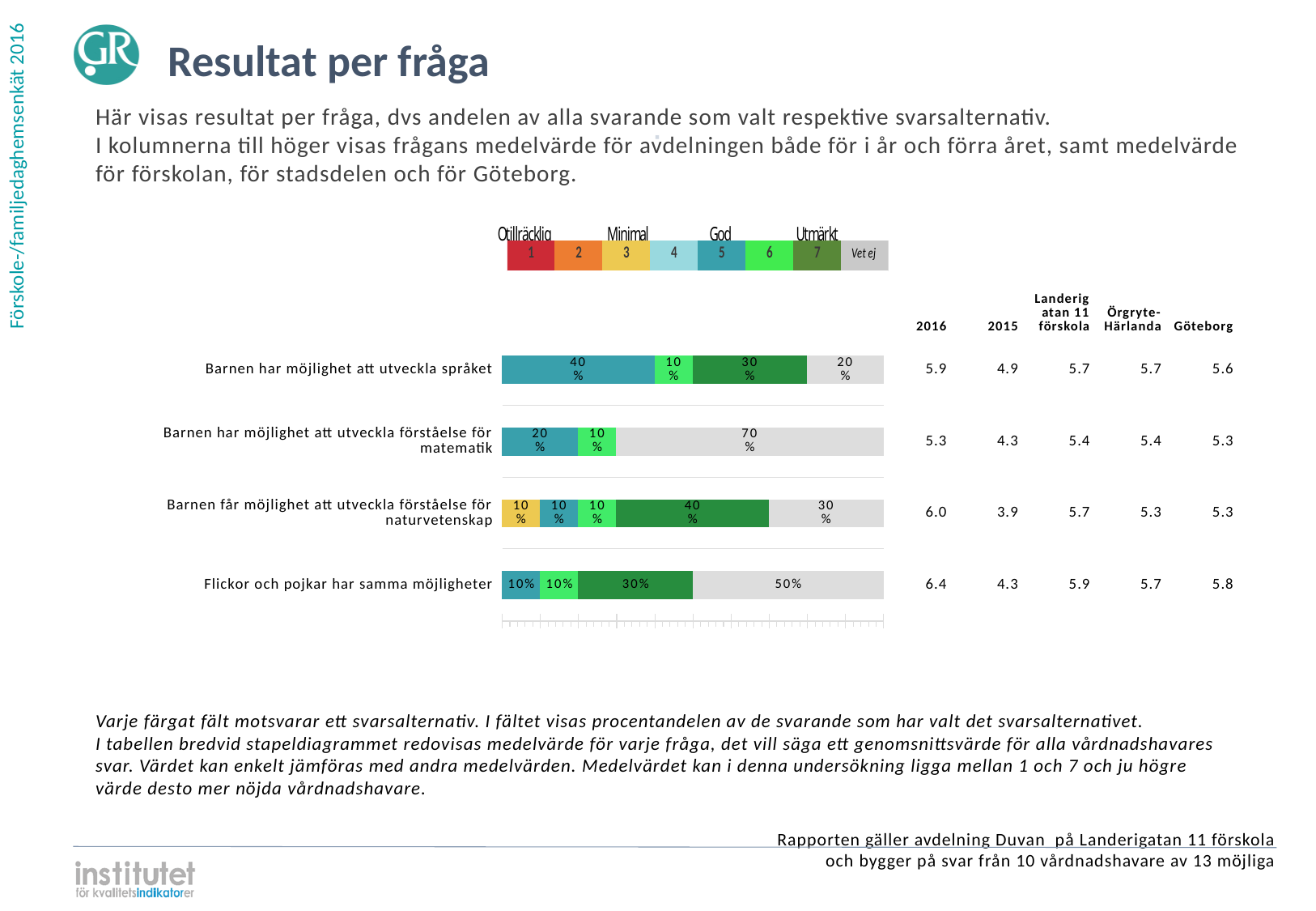
How many questions (categories) are plotted in the bar chart? 4 What is the difference between the 'Vet ej' share for 'Barnen har möjlighet att utveckla förståelse för matematik' and for 'Barnen har möjlighet att utveckla språket'? 50 percentage points What percentage of respondents chose 'Vet ej' for 'Flickor och pojkar har samma möjligheter'? 50% What percentage of respondents chose answer 7 (dark green segment) for 'Barnen får möjlighet att utveckla förståelse för naturvetenskap'? 40% What is the total of all segments in the bar for 'Flickor och pojkar har samma möjligheter'? 100% How many answer alternatives does the legend above the chart list, including 'Vet ej'? 8 What percentage of respondents chose 'Vet ej' for 'Barnen har möjlighet att utveckla förståelse för matematik'? 70% What percentage of respondents chose answer 5 (teal segment) for 'Barnen har möjlighet att utveckla språket'? 40% What kind of chart is shown on the slide? Stacked bar chart Which is larger: the answer-7 share for 'Barnen har möjlighet att utveckla språket' or for 'Barnen får möjlighet att utveckla förståelse för naturvetenskap'? Barnen får möjlighet att utveckla förståelse för naturvetenskap Which question has the largest 'Vet ej' share? Barnen har möjlighet att utveckla förståelse för matematik What is the 2016 mean value shown for 'Flickor och pojkar har samma möjligheter'? 6.4